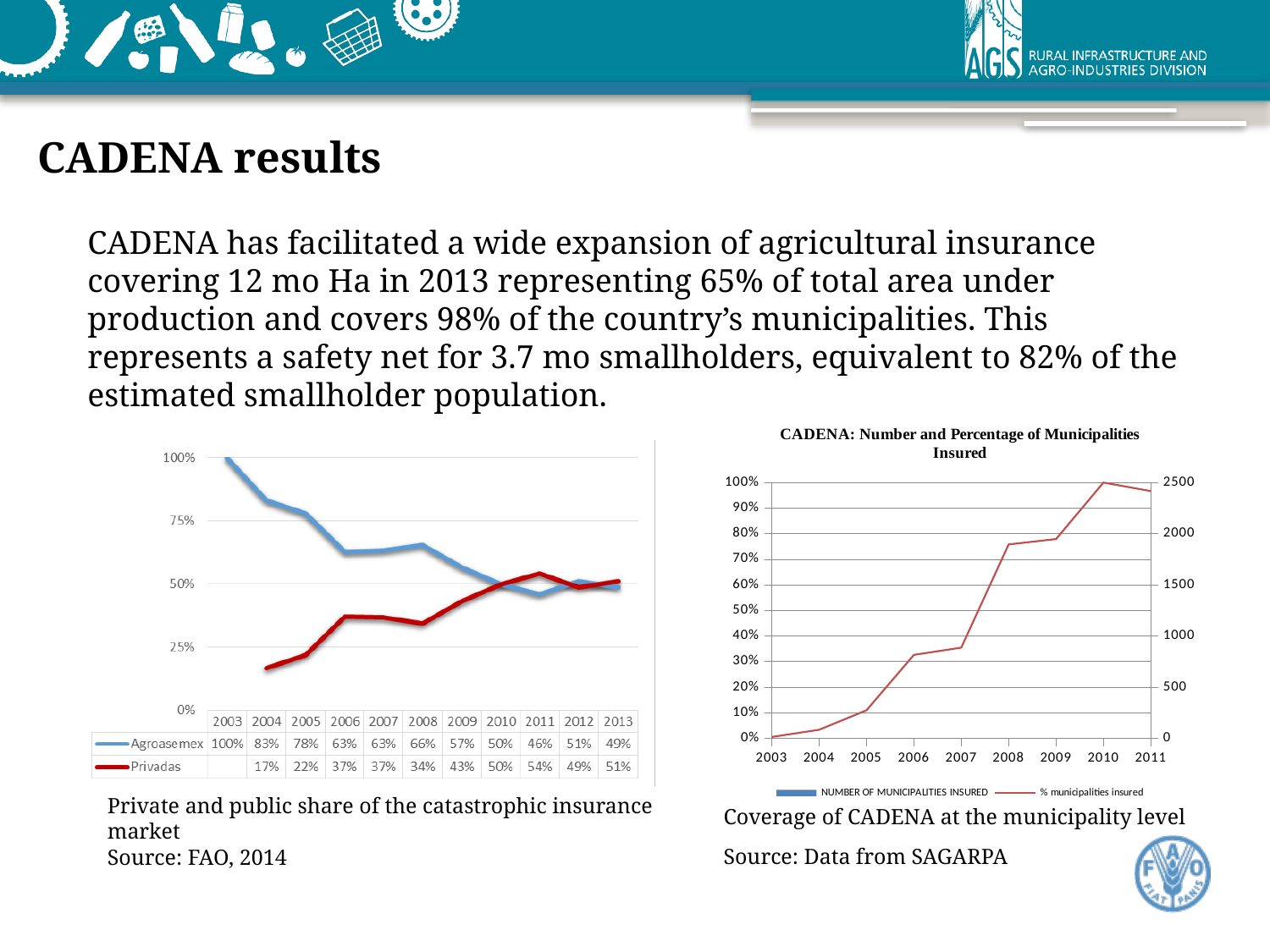
In the left chart on private and public share of the catastrophic insurance market, how many series are listed in the legend? 2 In the left chart on private and public share of the catastrophic insurance market, which series has the larger value in 2013, Agroasemex or Privadas? Privadas In the left chart on private and public share of the catastrophic insurance market, does the Agroasemex series generally rise or fall from 2003 to 2013? fall In the left chart on private and public share of the catastrophic insurance market, in which year is the Privadas value highest? 2011 What kind of chart is the chart titled 'CADENA: Number and Percentage of Municipalities Insured'? line chart In the chart titled 'CADENA: Number and Percentage of Municipalities Insured', is the % municipalities insured value for 2005 greater or less than 20%? less In the chart titled 'CADENA: Number and Percentage of Municipalities Insured', is the % municipalities insured value for 2008 greater or less than 70%? greater In the left chart on private and public share of the catastrophic insurance market, what is the value for Privadas in 2009? 43% In the left chart on private and public share of the catastrophic insurance market, what is the difference between the Agroasemex and Privadas values in 2008? 32% In the left chart on private and public share of the catastrophic insurance market, what is the value for Agroasemex in 2006? 63% In the chart titled 'CADENA: Number and Percentage of Municipalities Insured', how many years are shown on the x axis? 9 In the left chart on private and public share of the catastrophic insurance market, in which year is the Agroasemex value lowest? 2011